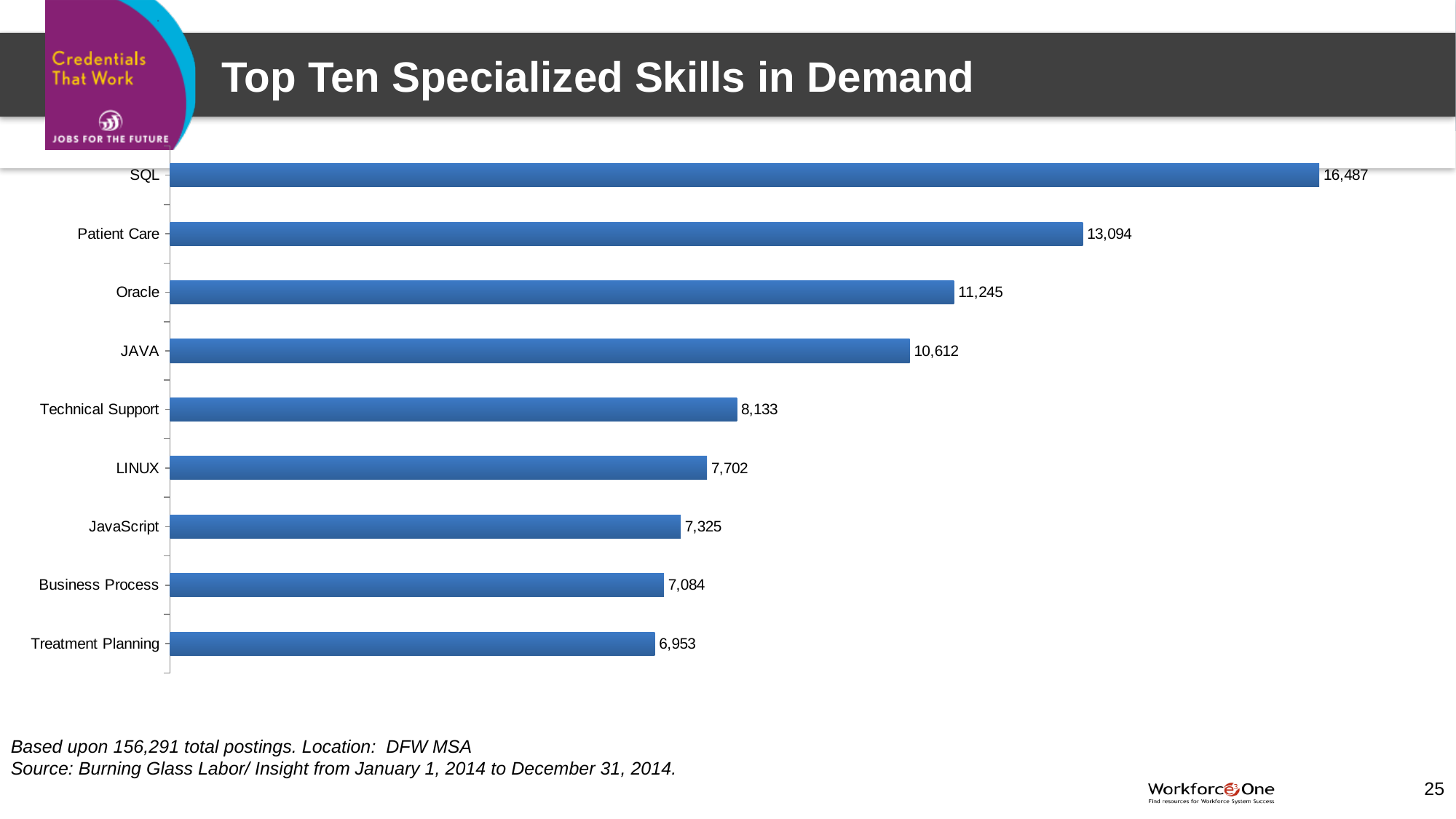
What kind of chart is shown on the slide? Bar chart What value is shown for Treatment Planning? 6,953 What is the difference between the values for SQL and Patient Care? 3,393 What is the difference between the values for Oracle and JAVA? 633 Which skill has the highest value? SQL How many skills are plotted in the chart? 9 What value is shown for Technical Support? 8,133 What value is shown for SQL? 16,487 Which has a larger value, LINUX or JavaScript? LINUX What is the title of the slide containing the chart? Top Ten Specialized Skills in Demand Which skill has the lowest value? Treatment Planning What value is shown for Patient Care? 13,094